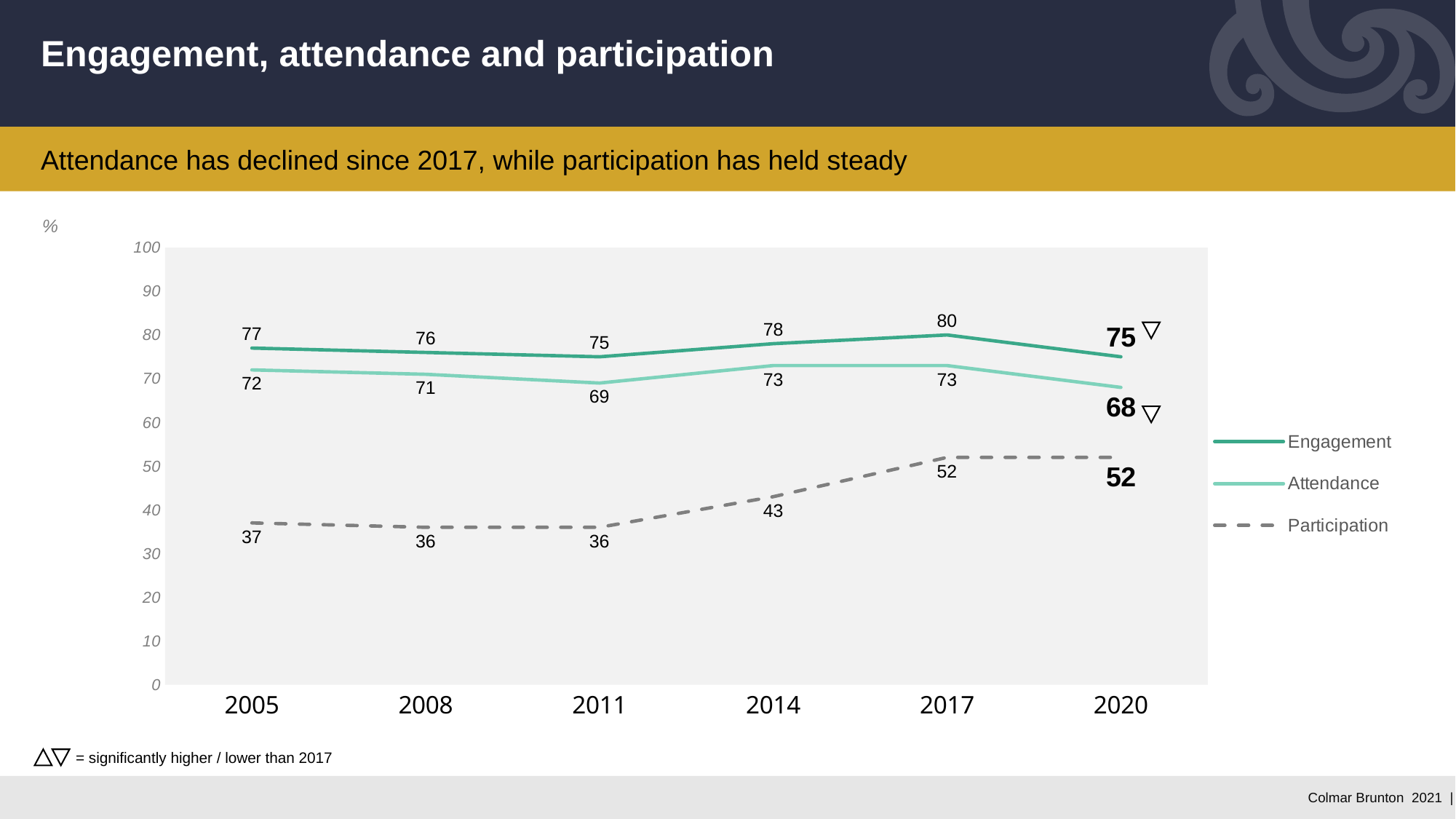
Which is larger in 2005, Engagement or Participation? Engagement Does Participation rise or fall between 2011 and 2017? Rise What kind of chart is shown on the slide? Line chart How many series does the legend list? 3 In which year is Participation lowest? 2008 and 2011 Which series is drawn with a dashed line? Participation What is the Participation value for 2014? 43 In which year is Engagement highest? 2017 What is the Engagement value for 2020? 75 What is the difference between the Attendance values for 2017 and 2020? 5 What is the Attendance value for 2011? 69 How many years are shown on the x axis? 6